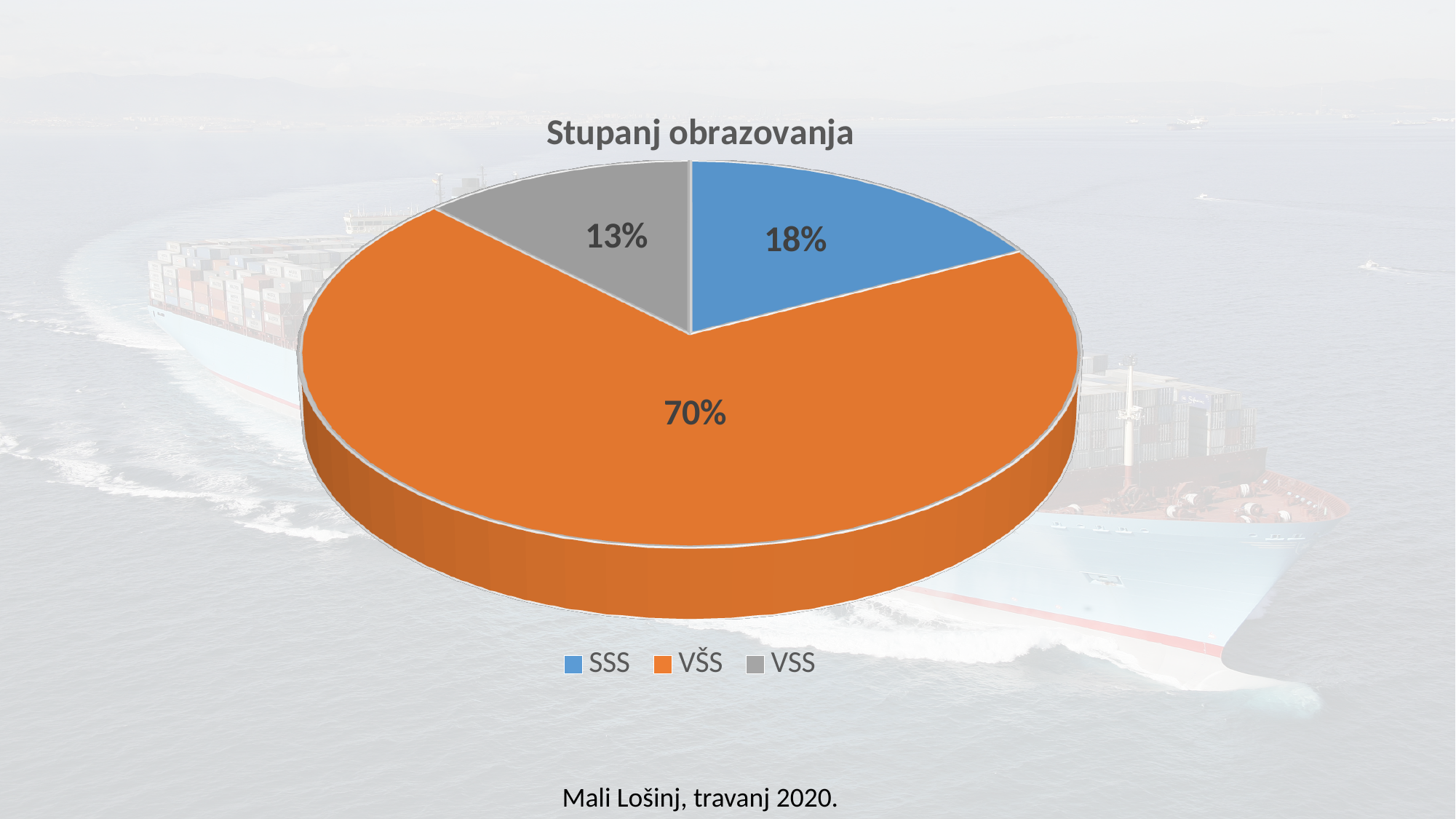
What share of the pie does SSS have? 18% What is the title of the chart? Stupanj obrazovanja What share of the pie does VSS have? 13% Which is larger, the share for SSS or the share for VSS? SSS How many categories does the pie chart show? 3 Which category has the largest slice of the pie? VŠS What share of the pie does VŠS have? 70% How many entries does the legend list? 3 What colour is the VŠS slice? orange What kind of chart is shown on the slide? pie chart What is the difference in percentage points between the VŠS share and the SSS share? 52 Which category has the smallest slice of the pie? VSS